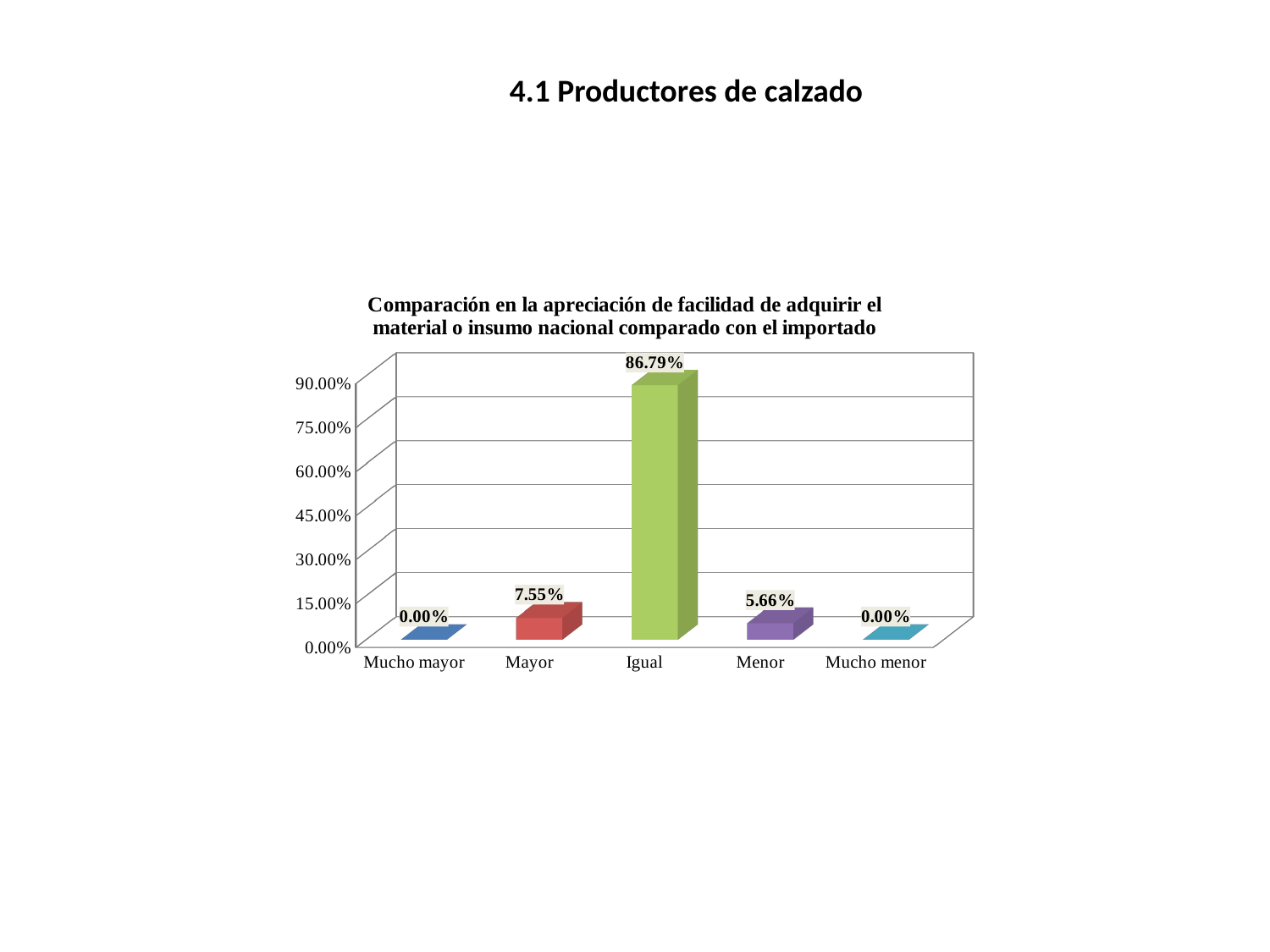
Which is larger, the value for Mayor or the value for Menor? Mayor What kind of chart is shown on the slide? Bar chart Which category has the highest value? Igual What is the value for Mucho mayor? 0.00% What is the title of the chart? Comparación en la apreciación de facilidad de adquirir el material o insumo nacional comparado con el importado What is the difference between the values for Igual and Mayor? 79.24% What is the difference between the values for Mayor and Menor? 1.89% Is the value for Igual greater or less than 75.00%? greater How many categories are shown on the x axis? 5 What is the value for Mayor? 7.55% What is the value for Igual? 86.79% What is the value for Menor? 5.66%